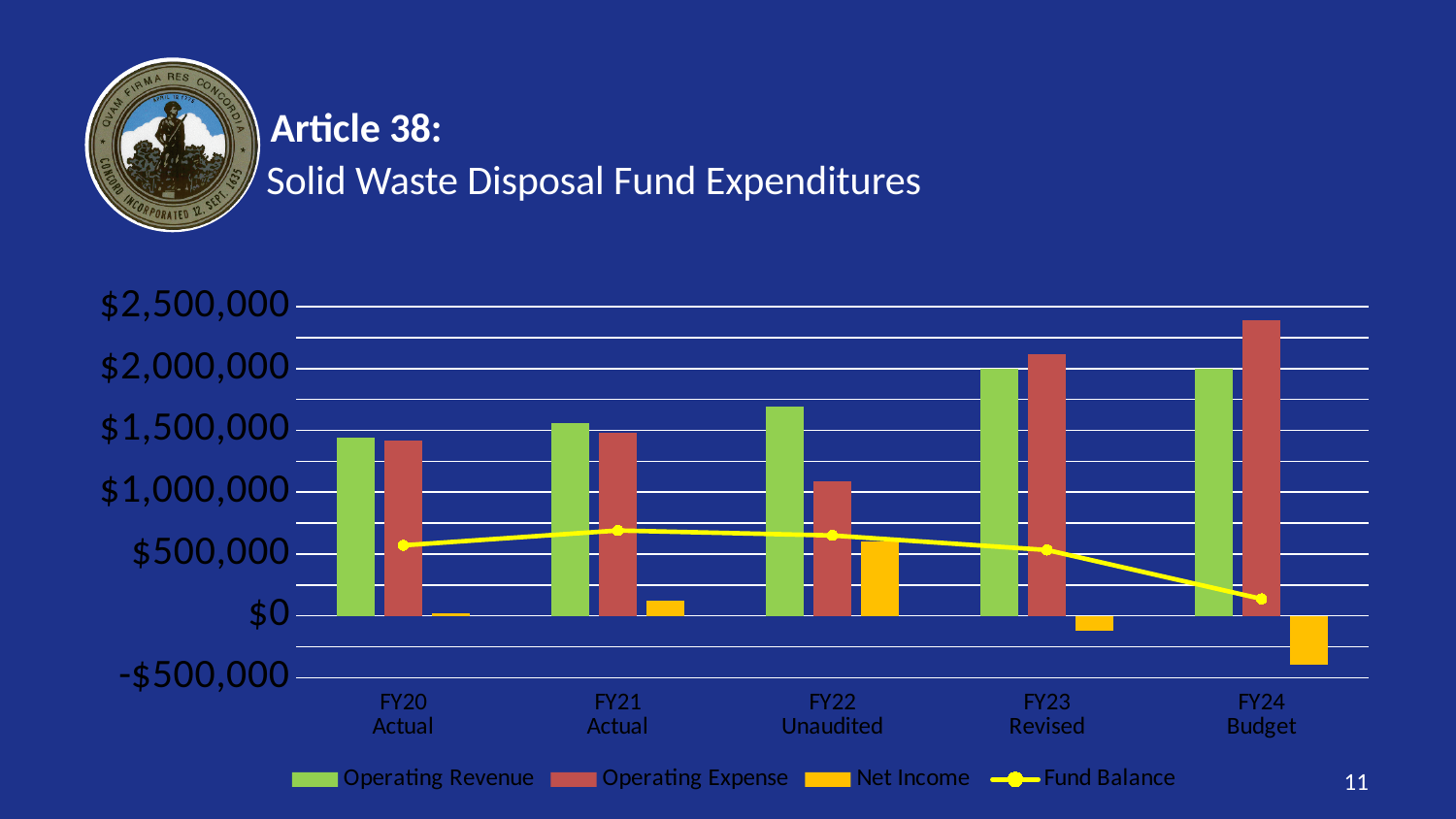
In which fiscal year is Net Income lowest? FY24 Budget For FY22 Unaudited, which is larger: Operating Revenue or Operating Expense? Operating Revenue Is the Fund Balance for FY24 Budget greater or less than $500,000? less What kind of chart is shown on the slide? bar chart with a line In which fiscal year is Operating Revenue lowest? FY20 Actual In which fiscal year is Operating Expense highest? FY24 Budget How many fiscal year categories are shown on the x axis? 5 How many series does the legend list? 4 Does the Fund Balance line rise or fall from FY22 Unaudited to FY24 Budget? fall In which fiscal year is Net Income highest? FY22 Unaudited Is the Operating Expense for FY24 Budget greater or less than $2,000,000? greater Is the Operating Expense for FY22 Unaudited greater or less than $1,500,000? less